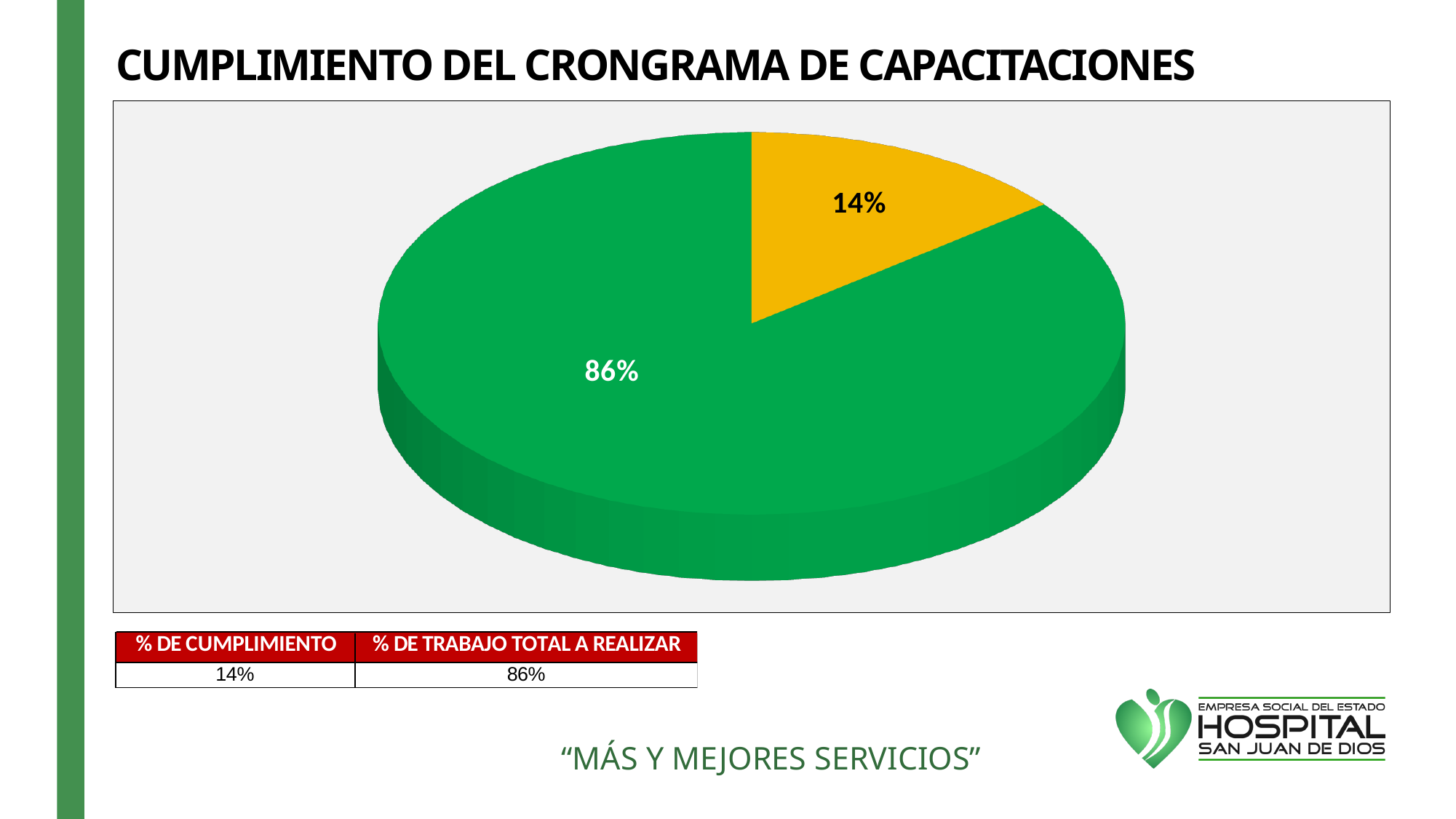
Which category has the largest slice of the pie? % DE TRABAJO TOTAL A REALIZAR What share of the pie does the yellow slice represent? 14% How many slices does the pie chart have? 2 What is the difference in percentage points between the 86% slice and the 14% slice? 72 What kind of chart is shown on the slide? pie chart What share of the pie does the green slice represent? 86% What percentage is shown for % DE TRABAJO TOTAL A REALIZAR? 86% What is the title of the slide containing the pie chart? CUMPLIMIENTO DEL CRONGRAMA DE CAPACITACIONES Which category has the smallest slice of the pie? % DE CUMPLIMIENTO What colour is the slice labelled 14%? yellow Which is larger, % DE CUMPLIMIENTO or % DE TRABAJO TOTAL A REALIZAR? % DE TRABAJO TOTAL A REALIZAR What percentage is shown for % DE CUMPLIMIENTO? 14%